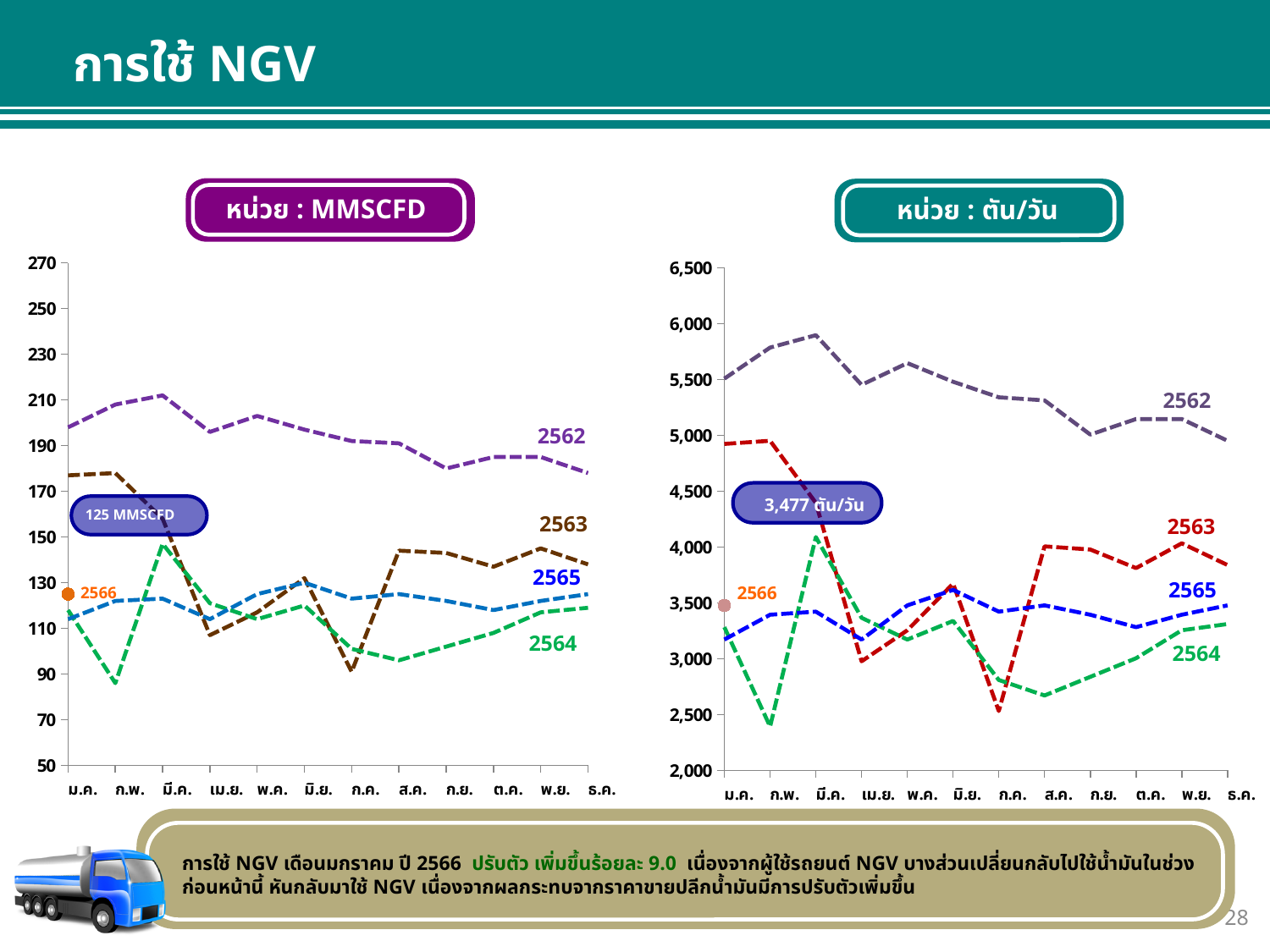
On the right chart (หน่วย : ตัน/วัน), is the value for 2564 in ก.พ. greater or less than 3,000? less How many months are shown on the x axis of the left chart (หน่วย : MMSCFD)? 12 On the right chart (หน่วย : ตัน/วัน), in ก.ค., which is larger: the value for 2563 or the value for 2565? 2565 On the left chart (หน่วย : MMSCFD), which year's line is the highest across the months? 2562 On the right chart (หน่วย : ตัน/วัน), is the value for 2562 in ก.พ. greater or less than 5,500? greater On the right chart (หน่วย : ตัน/วัน), what value is labelled for the 2566 point in ม.ค.? 3,477 ตัน/วัน On the left chart (หน่วย : MMSCFD), is the value for 2564 in ก.พ. greater or less than 110? less On the left chart (หน่วย : MMSCFD), does the 2564 line rise or fall from ก.ค. to ธ.ค.? rise On the right chart (หน่วย : ตัน/วัน), which year's line is the highest across the months? 2562 What kind of chart is the left chart (หน่วย : MMSCFD)? line chart On the left chart (หน่วย : MMSCFD), what value is labelled for the 2566 point in ม.ค.? 125 MMSCFD How many years are labelled on the right chart (หน่วย : ตัน/วัน)? 5